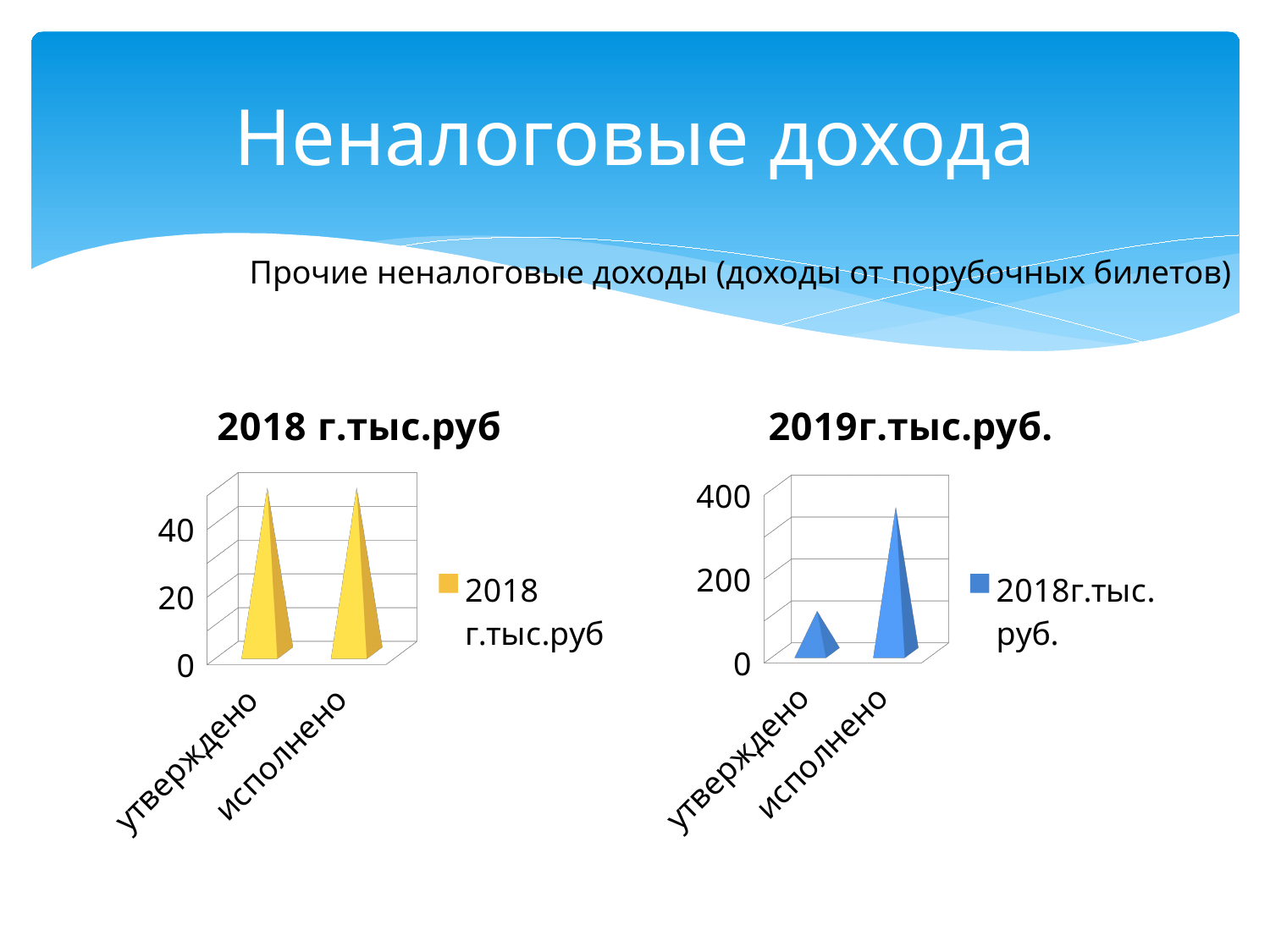
In the chart titled "2018 г.тыс.руб", is the value for утверждено greater or less than 40? greater In the chart titled "2019г.тыс.руб.", which category has the lowest value? утверждено What colour are the bars in the chart titled "2019г.тыс.руб."? blue In the chart titled "2018 г.тыс.руб", is the value for исполнено greater or less than 20? greater In the chart titled "2019г.тыс.руб.", is the value for исполнено greater or less than 200? greater In the chart titled "2019г.тыс.руб.", which is larger: утверждено or исполнено? исполнено How many categories are shown on the x axis of the chart titled "2018 г.тыс.руб"? 2 What is the legend entry of the chart titled "2018 г.тыс.руб"? 2018 г.тыс.руб What kind of chart is the chart titled "2018 г.тыс.руб"? bar chart How many series does the legend of the chart titled "2019г.тыс.руб." list? 1 In the chart titled "2019г.тыс.руб.", which category has the highest value? исполнено